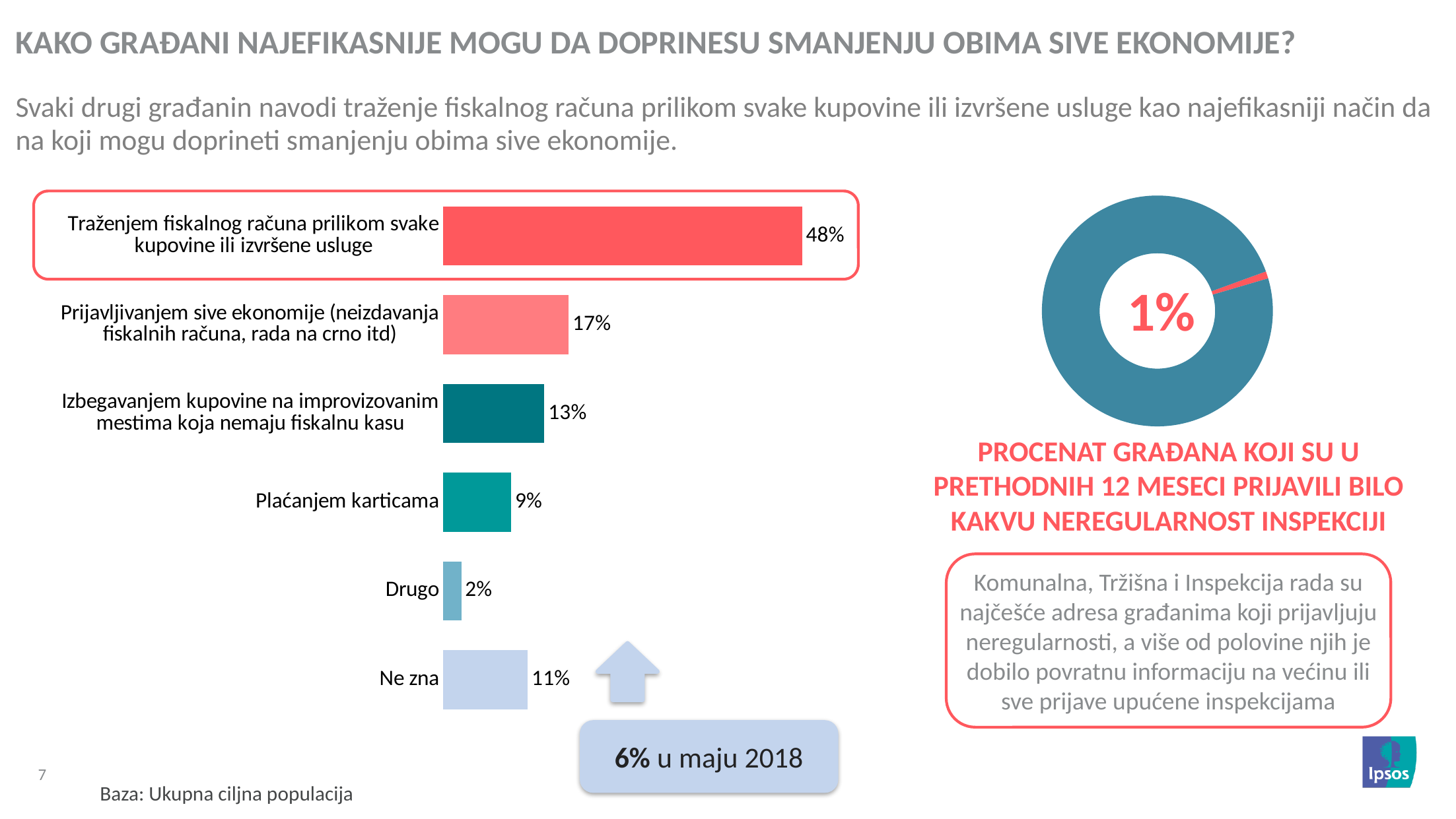
How many categories does the bar chart on the left show? 6 In the bar chart on the left, what is the value for "Izbegavanjem kupovine na improvizovanim mestima koja nemaju fiskalnu kasu"? 13% In the bar chart on the left, what is the value for "Plaćanjem karticama"? 9% In the bar chart on the left, what is the value for "Ne zna"? 11% In the bar chart on the left, which category has the highest value? Traženjem fiskalnog računa prilikom svake kupovine ili izvršene usluge In the bar chart on the left, which category has the lowest value? Drugo In the donut chart on the right, what percentage of citizens reported an irregularity to an inspection in the previous 12 months? 1% In the bar chart on the left, what was the value for "Ne zna" in May 2018, according to the callout below the chart? 6% What kind of chart is shown on the left of the slide? Bar chart What kind of chart is shown on the right of the slide? Donut chart In the bar chart on the left, what is the difference between the values for "Traženjem fiskalnog računa prilikom svake kupovine ili izvršene usluge" and "Prijavljivanjem sive ekonomije (neizdavanja fiskalnih računa, rada na crno itd)"? 31% In the bar chart on the left, which is larger: the value for "Ne zna" or the value for "Plaćanjem karticama"? Ne zna